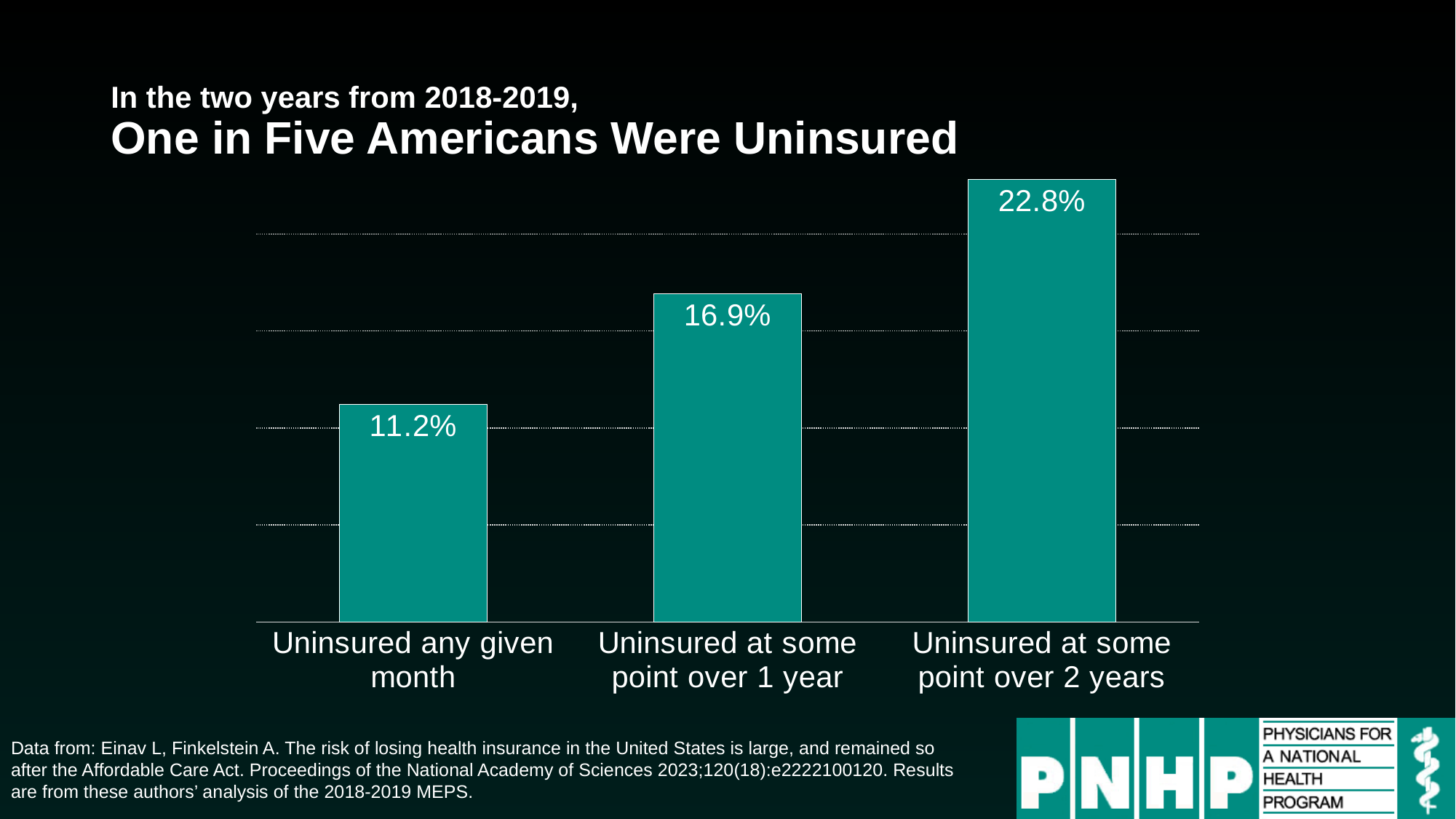
What is the value for 'Uninsured at some point over 2 years'? 22.8% Which category has the lowest value? Uninsured any given month What is the difference between the values for 'Uninsured at some point over 2 years' and 'Uninsured any given month'? 11.6% Do the values rise or fall from left to right along the x axis? Rise Which category has the highest value? Uninsured at some point over 2 years How many categories are shown in the chart? 3 What is the main title of the slide above the chart? One in Five Americans Were Uninsured What kind of chart is shown on the slide? Bar chart Which is larger: the value for 'Uninsured at some point over 1 year' or 'Uninsured any given month'? Uninsured at some point over 1 year What is the difference between the values for 'Uninsured at some point over 1 year' and 'Uninsured any given month'? 5.7% What is the value for 'Uninsured at some point over 1 year'? 16.9% What is the value for 'Uninsured any given month'? 11.2%